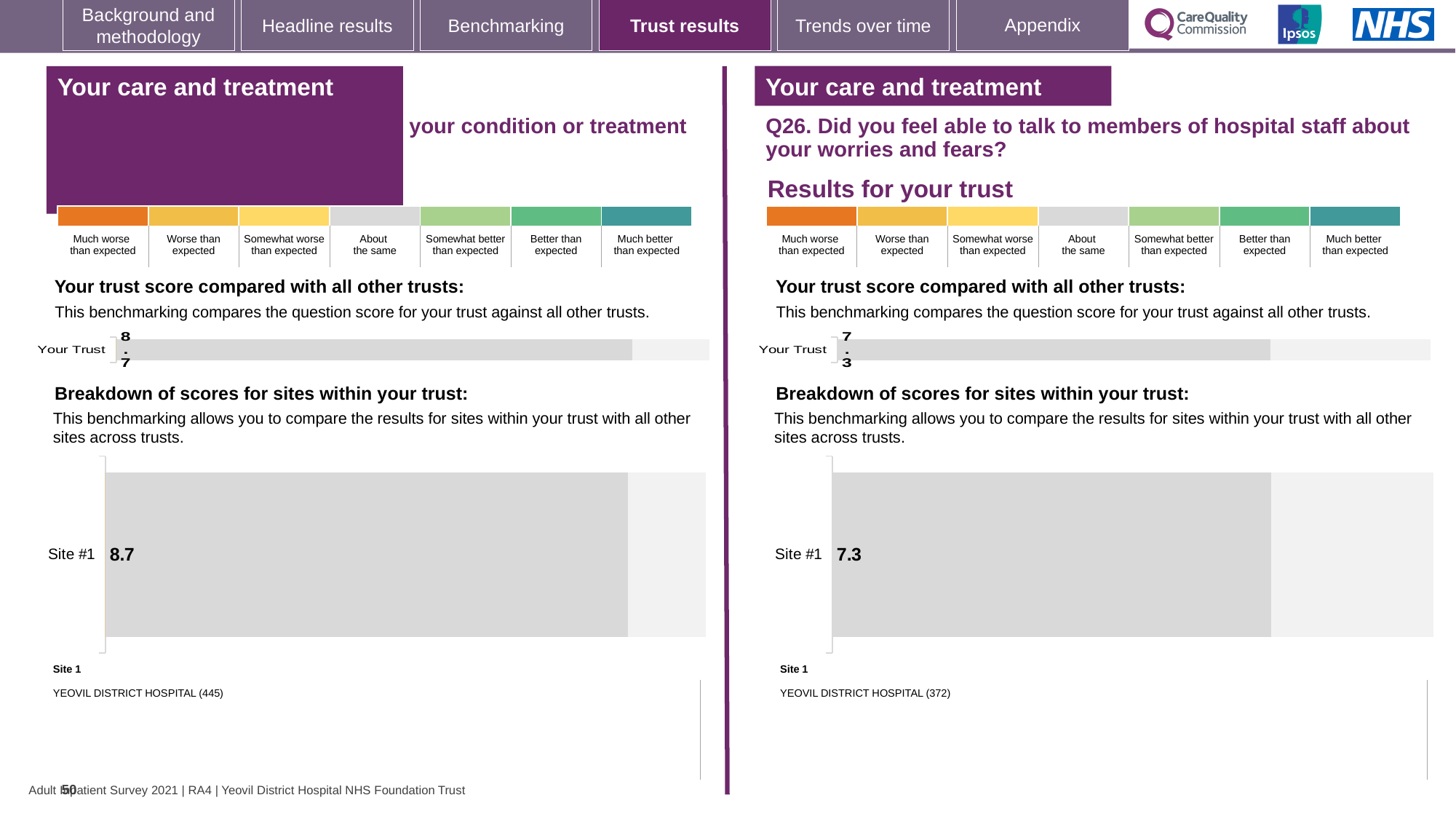
On the left panel, what is the score shown for Your Trust in the 'Your trust score compared with all other trusts' chart? 8.7 On the left panel, what score is shown for Site #1 in the 'Breakdown of scores for sites within your trust' chart? 8.7 Which is larger: the Your Trust score on the left panel or the Your Trust score on the right panel (Q26)? Left panel (8.7) What is the difference between the Site #1 score on the left panel and the Site #1 score on the right panel (Q26)? 1.4 On the right panel (Q26), what is the score shown for Your Trust in the 'Your trust score compared with all other trusts' chart? 7.3 Which site name is listed as Site 1 below the left panel chart? YEOVIL DISTRICT HOSPITAL (445) Which site name is listed as Site 1 below the right panel (Q26) chart? YEOVIL DISTRICT HOSPITAL (372) How many sites are shown in the 'Breakdown of scores for sites within your trust' chart on the right panel (Q26)? 1 Is the Your Trust score on the right panel (Q26) greater or less than the Site #1 score on the left panel? less How many sites are shown in the 'Breakdown of scores for sites within your trust' chart on the left panel? 1 On the right panel (Q26), what score is shown for Site #1 in the 'Breakdown of scores for sites within your trust' chart? 7.3 What type of chart is used to show the Site #1 score on the right panel (Q26)? Bar chart